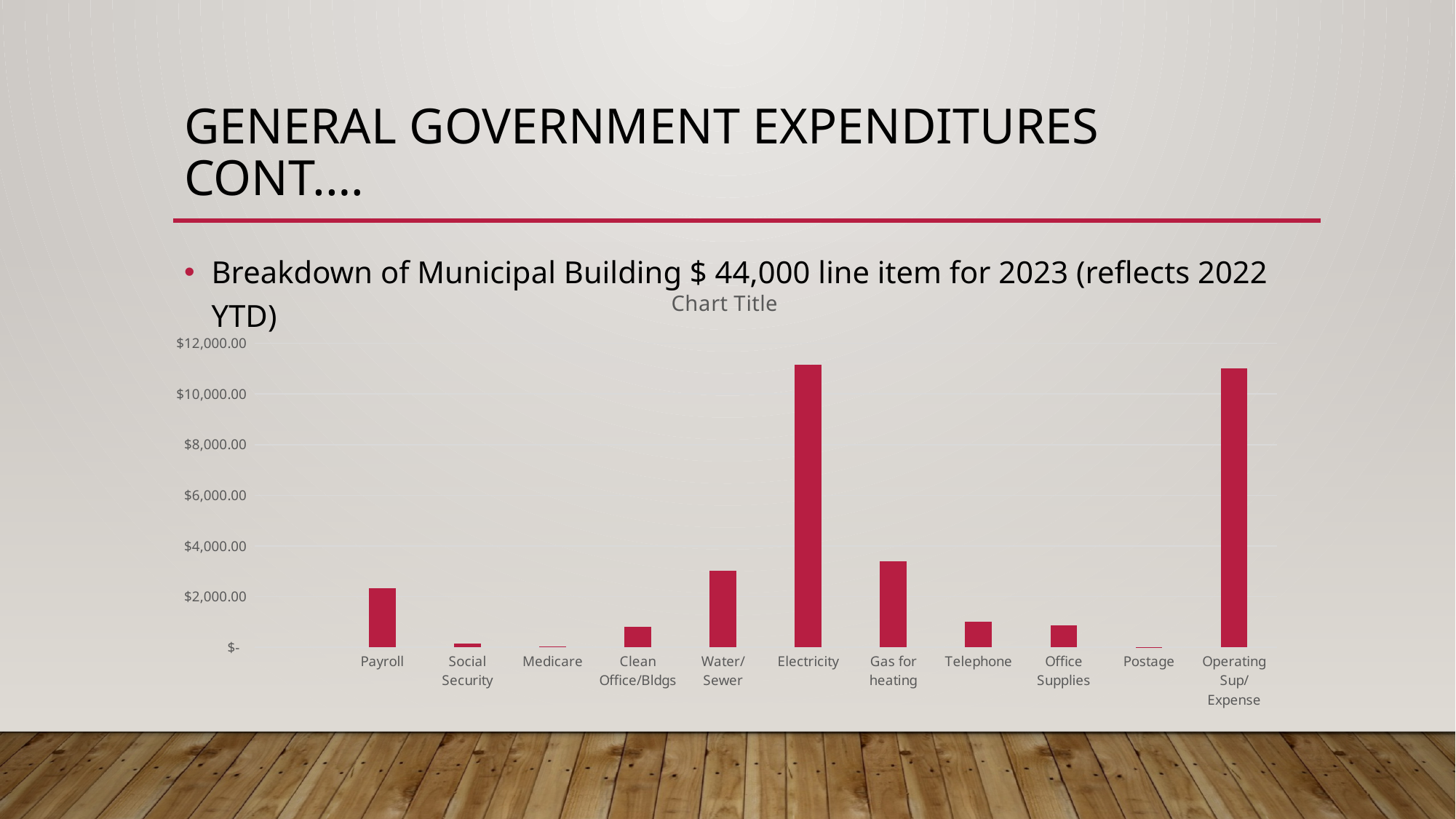
Is the value for Telephone greater or less than $2,000.00? less Is the value for Gas for heating greater or less than $4,000.00? less Is the value for Payroll greater or less than $4,000.00? less Which is larger, the value for Gas for heating or the value for Water/Sewer? Gas for heating How many categories are plotted on the chart? 11 What is the title shown above the chart? Chart Title What kind of chart is shown on the slide? Bar chart Which is larger, the value for Electricity or the value for Payroll? Electricity Which is larger, the value for Water/Sewer or the value for Payroll? Water/Sewer